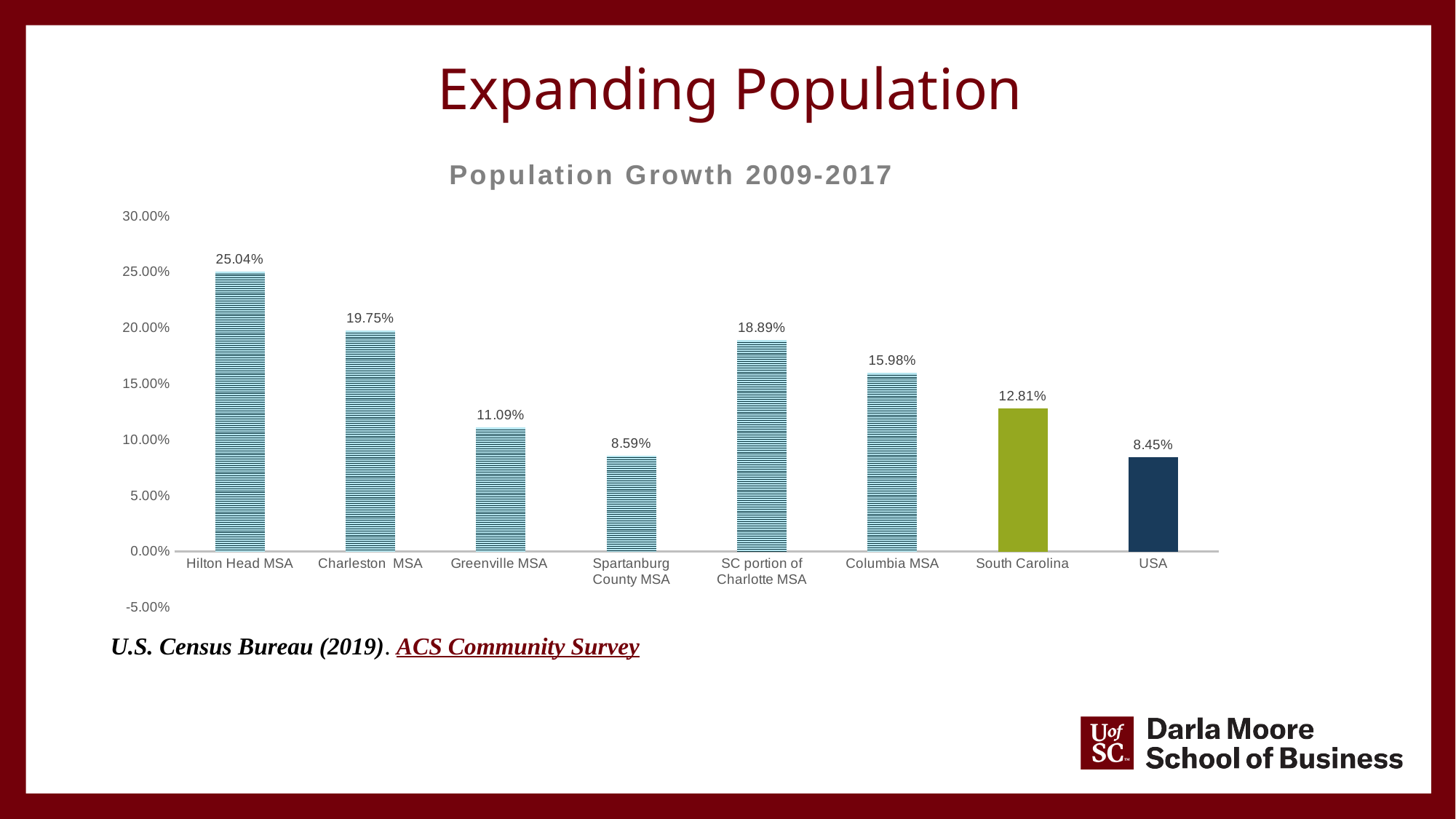
Is the value for Columbia MSA greater or less than 15.00%? greater What is the population growth value for Hilton Head MSA? 25.04% What is the population growth value for the SC portion of Charlotte MSA? 18.89% What kind of chart is shown on the slide? Bar chart Which category has the highest population growth? Hilton Head MSA How many categories are shown on the chart? 8 Which category has the lowest population growth? USA What is the population growth value for the USA? 8.45% What is the difference between the population growth of Charleston MSA and Columbia MSA? 3.77% Which has a higher population growth, Greenville MSA or Spartanburg County MSA? Greenville MSA What is the title of the chart? Population Growth 2009-2017 What is the population growth value for South Carolina? 12.81%